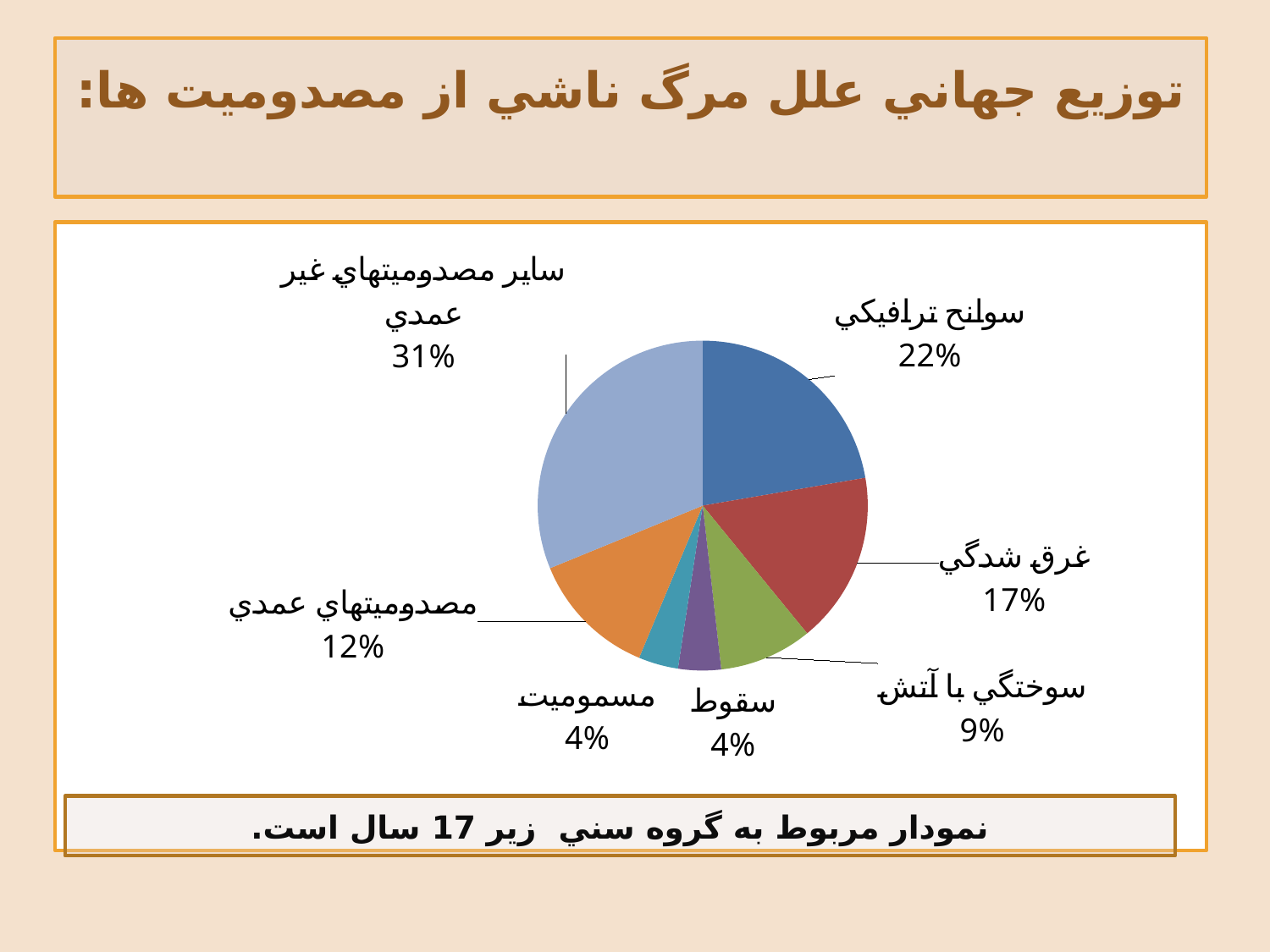
How many slices does the pie chart have? 7 What percentage is shown for سقوط? 4% According to the caption below the chart, which age group does the chart refer to? زير 17 سال What share of the pie is labelled سوانح ترافيكي? 22% What share of the pie is labelled غرق شدگي? 17% Which category has the largest slice of the pie? ساير مصدوميتهاي غير عمدي What share of the pie is labelled سوختگي با آتش? 9% Which is larger, the slice for غرق شدگي or the slice for مصدوميتهاي عمدي? غرق شدگي What kind of chart is shown on the slide? pie chart What is the difference in percentage points between سوانح ترافيكي and سوختگي با آتش? 13 What is the percentage shown for the largest slice, ساير مصدوميتهاي غير عمدي? 31%